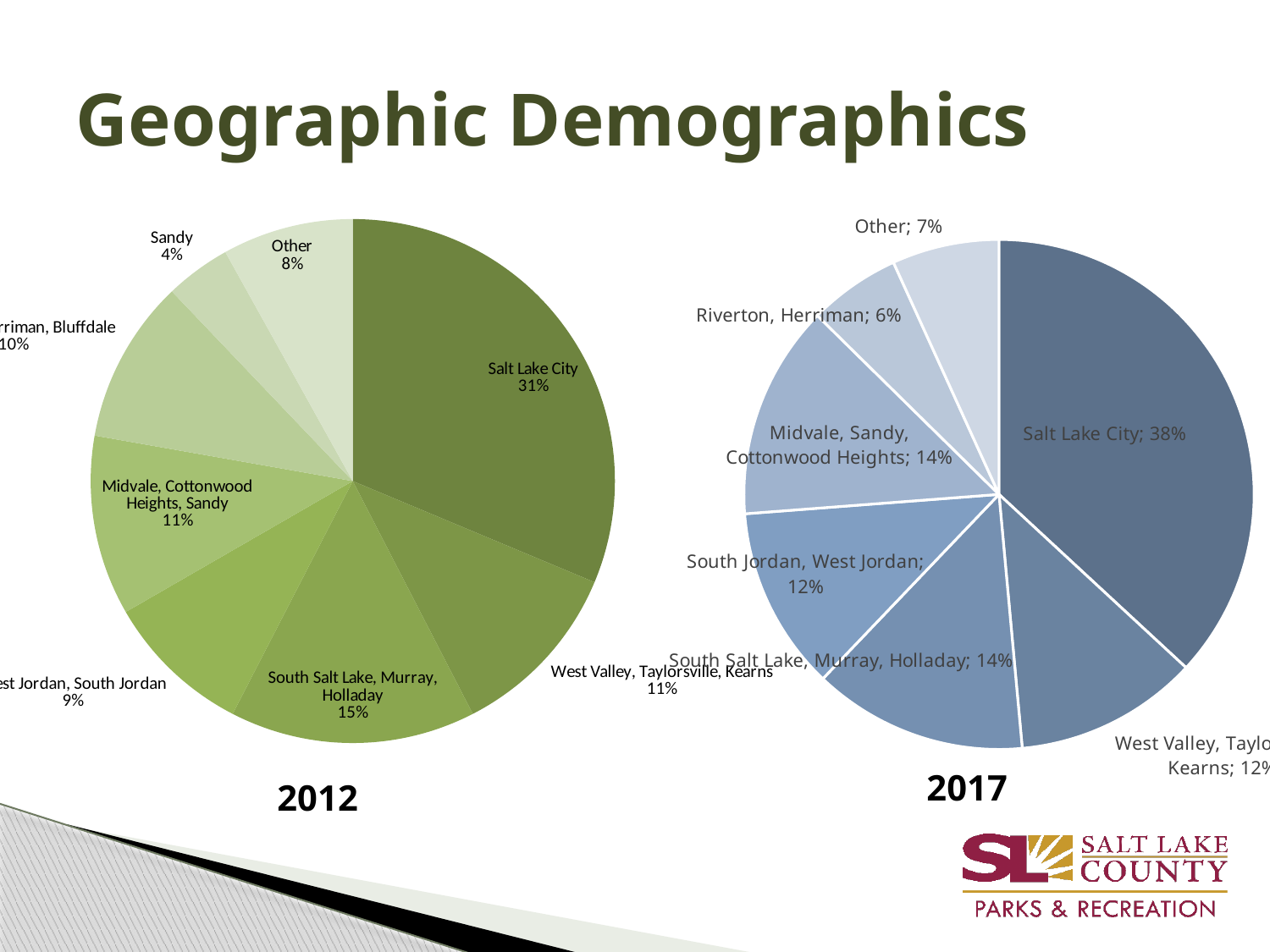
In the 2017 pie chart, what share does Salt Lake City have? 38% In the 2012 pie chart, which category has the smallest share? Sandy In the 2012 pie chart, what share does Salt Lake City have? 31% In the 2012 pie chart, which category has the largest share? Salt Lake City In the 2017 pie chart, what percentage is shown for Other? 7% In the 2017 pie chart, which category has the smallest share? Riverton, Herriman How many slices does the 2017 pie chart have? 7 In the 2012 pie chart, which is larger: Other or Sandy? Other In the 2012 pie chart, what percentage is shown for South Salt Lake, Murray, Holladay? 15% In the 2017 pie chart, what percentage is shown for Riverton, Herriman? 6% How much larger is Salt Lake City's share in the 2017 pie chart than in the 2012 pie chart? 7 percentage points What type of chart is used for the 2012 and 2017 data? Pie chart